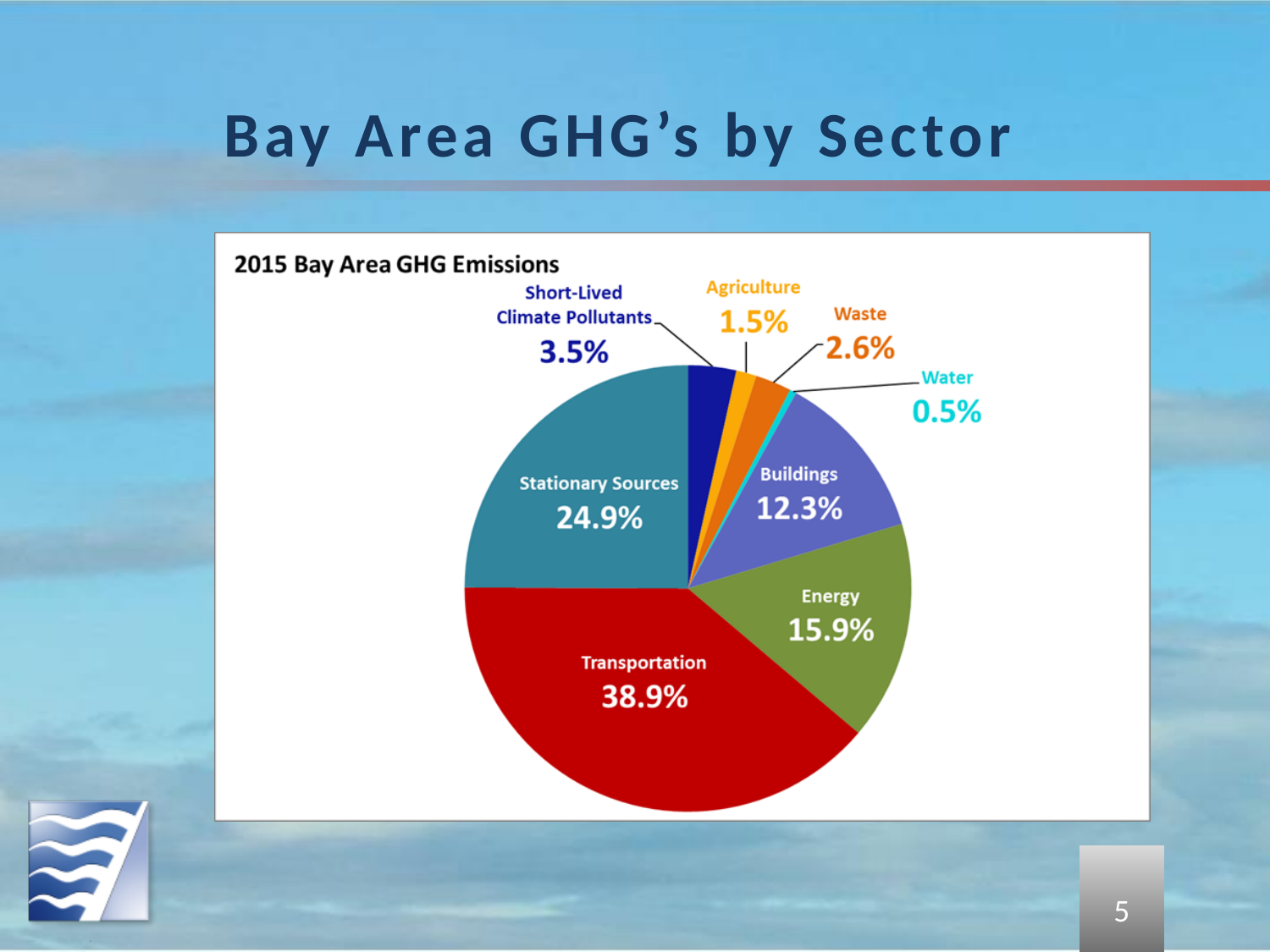
How many sectors are shown in the pie chart? 8 What kind of chart is shown on the slide? Pie chart Which is larger, the share for Energy or the share for Buildings? Energy What percentage of emissions is attributed to Stationary Sources? 24.9% What is the value shown for Buildings? 12.3% What is the combined share of Agriculture and Waste? 4.1% Which sector has the smallest share of emissions? Water What share of 2015 Bay Area GHG emissions comes from Transportation? 38.9% What percentage is shown for Water? 0.5% What is the difference in percentage points between Transportation and Stationary Sources? 14.0 Which sector has the largest share of emissions? Transportation What is the title of the chart? 2015 Bay Area GHG Emissions